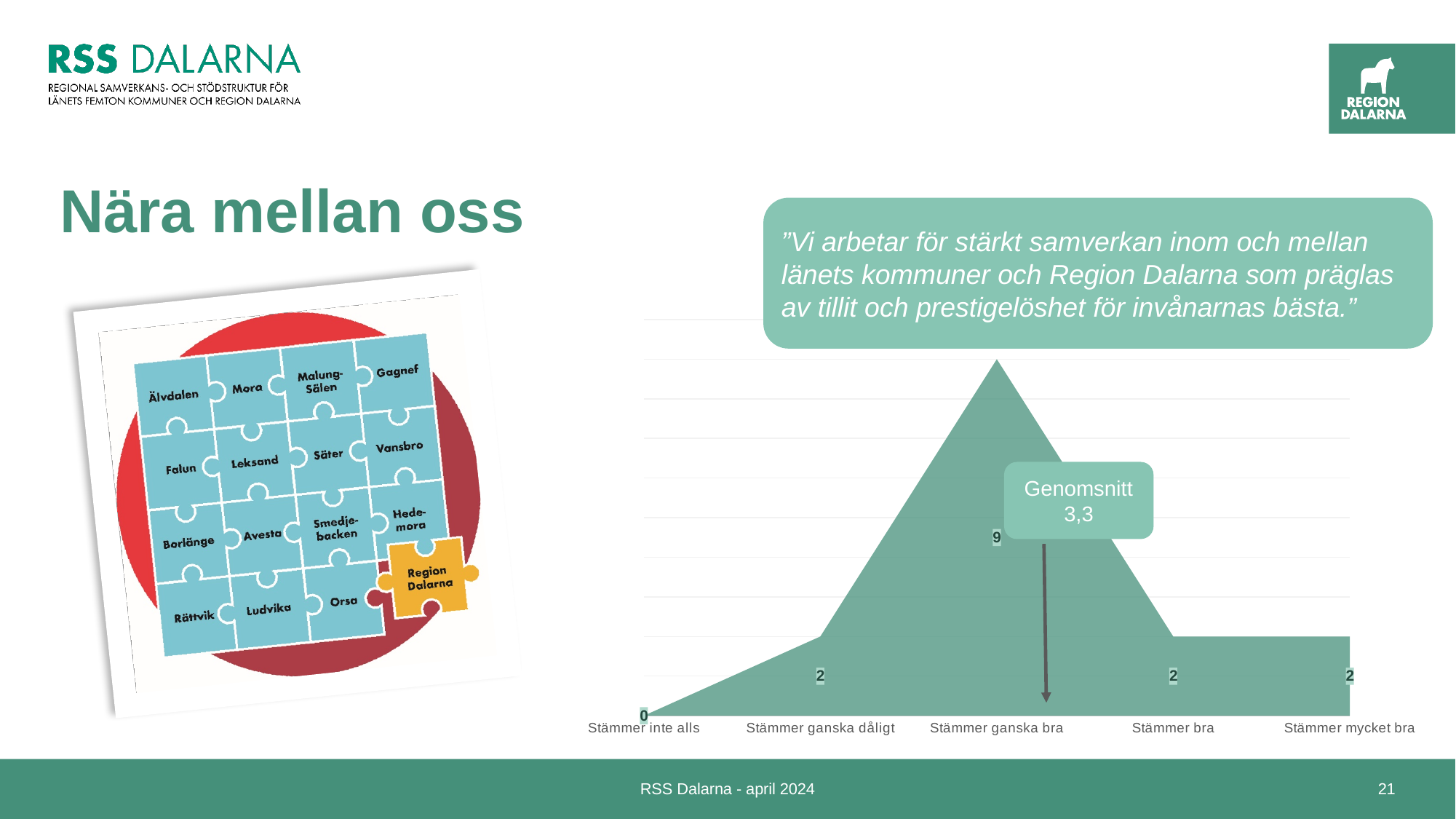
What is the value for "Stämmer ganska dåligt" in the chart? 2 What is the total of all the values plotted in the chart? 15 What kind of chart is shown on the slide? Area chart How many categories are shown on the x axis of the chart? 5 Which category has the lowest value in the chart? Stämmer inte alls What average (Genomsnitt) value is annotated on the chart? 3,3 What is the value for "Stämmer mycket bra" in the chart? 2 What is the value for "Stämmer ganska bra" in the chart? 9 Which category has the highest value in the chart? Stämmer ganska bra What is the value for "Stämmer inte alls" in the chart? 0 Which is larger: the value for "Stämmer ganska dåligt" or the value for "Stämmer ganska bra"? Stämmer ganska bra What is the difference between the values for "Stämmer ganska bra" and "Stämmer bra"? 7